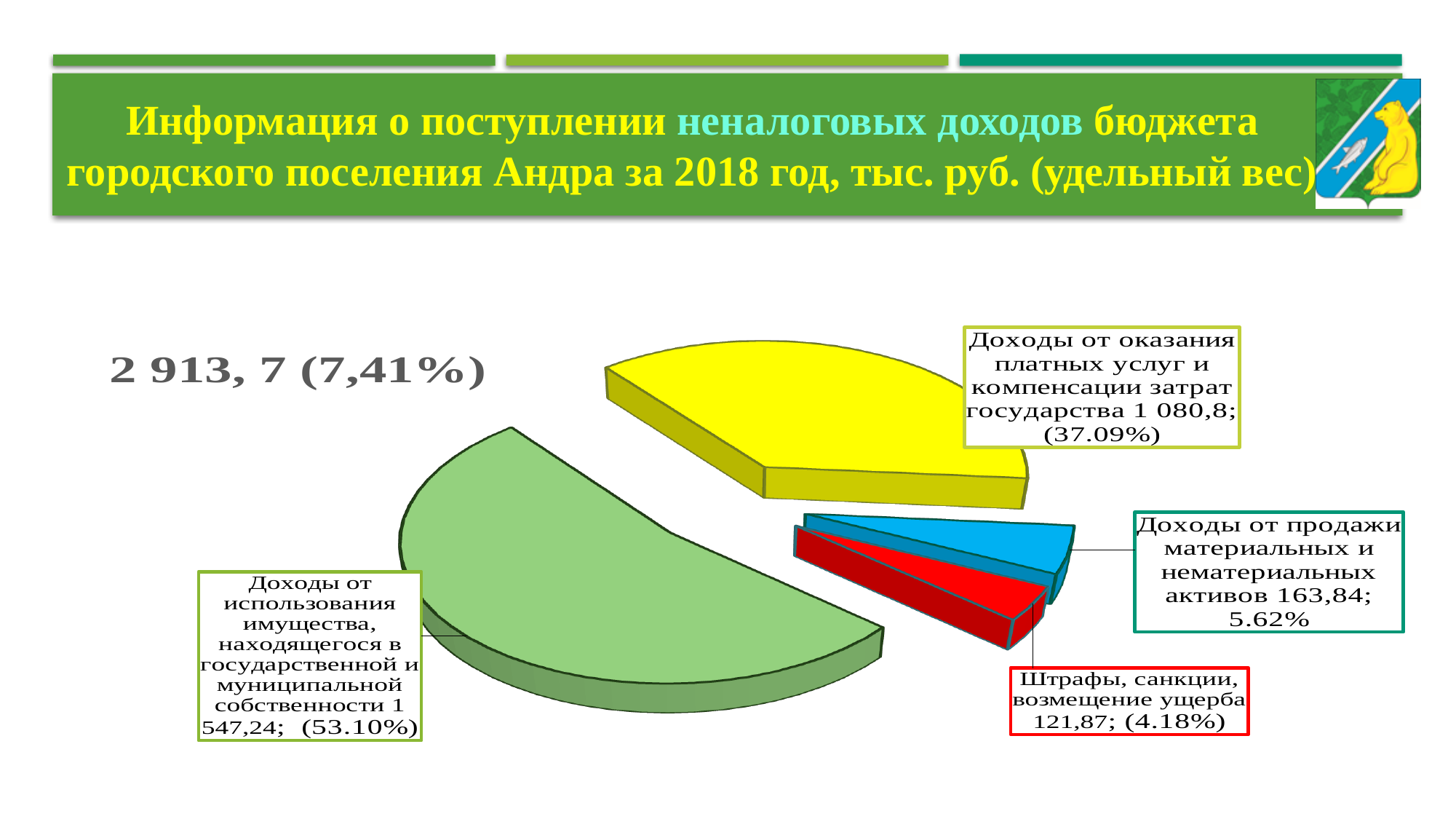
What value is shown for "Штрафы, санкции, возмещение ущерба"? 121,87 What share of the pie does "Доходы от оказания платных услуг и компенсации затрат государства" represent? 37.09% Which is larger: "Доходы от продажи материальных и нематериальных активов" or "Штрафы, санкции, возмещение ущерба"? Доходы от продажи материальных и нематериальных активов Which category has the smallest slice of the pie? Штрафы, санкции, возмещение ущерба What colour is the slice for "Штрафы, санкции, возмещение ущерба"? red What is the difference between the values for "Доходы от использования имущества" and "Доходы от оказания платных услуг"? 466,44 Which category has the largest slice of the pie? Доходы от использования имущества, находящегося в государственной и муниципальной собственности How many slices does the pie chart have? 4 What share of the pie does "Доходы от продажи материальных и нематериальных активов" represent? 5.62% What total value is printed to the left of the pie chart? 2 913, 7 (7,41%) What type of chart is shown on the slide? pie chart What value is shown for "Доходы от использования имущества, находящегося в государственной и муниципальной собственности"? 1 547,24